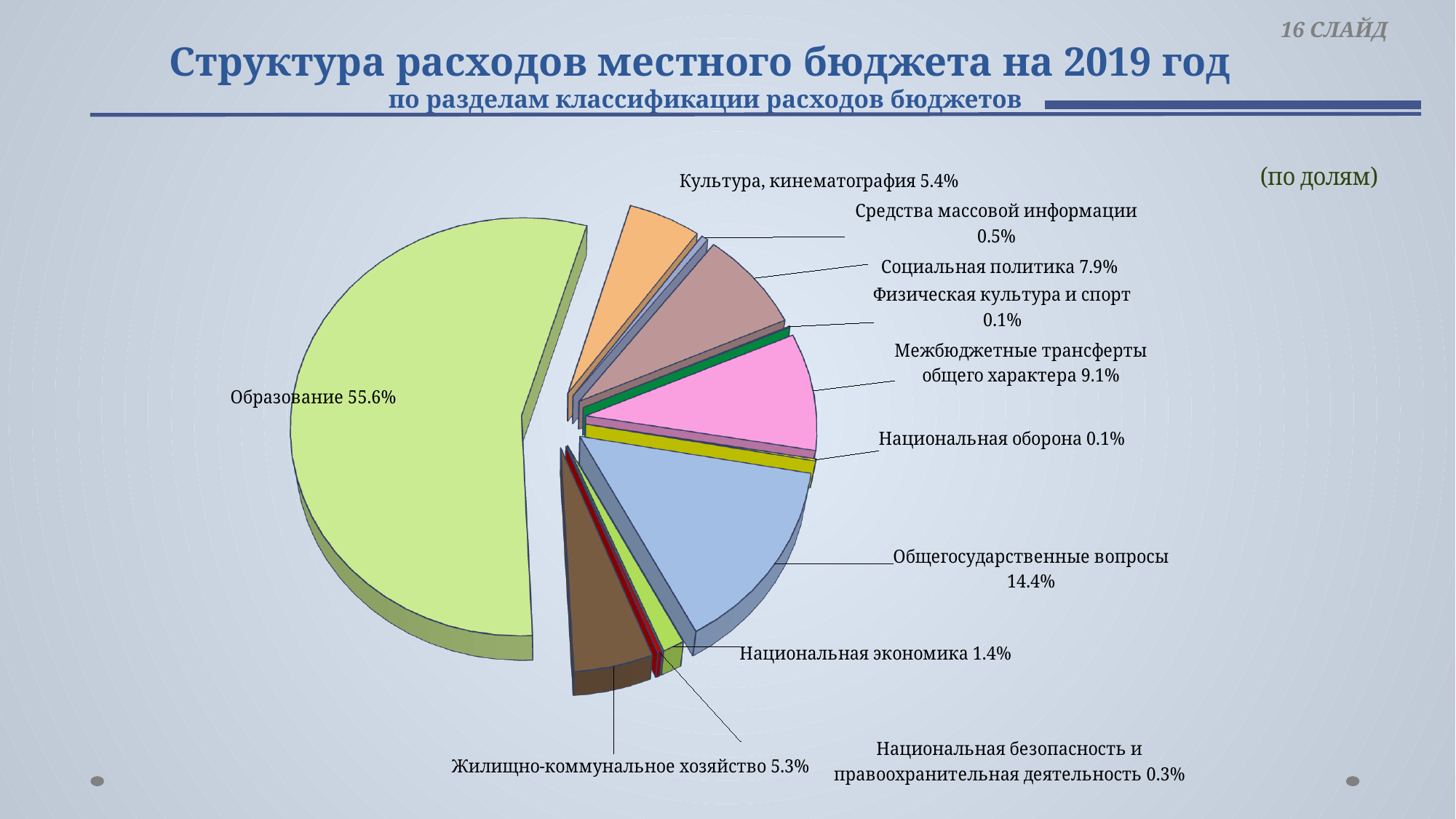
What is the value for Национальная безопасность и правоохранительная деятельность? 0.3% What share of the local budget expenditure goes to Образование? 55.6% What is the value for Жилищно-коммунальное хозяйство? 5.3% What is the value for Общегосударственные вопросы? 14.4% Which is larger, Культура, кинематография or Жилищно-коммунальное хозяйство? Культура, кинематография Which category has the largest share of the pie? Образование What is the value for Межбюджетные трансферты общего характера? 9.1% What is the value for Социальная политика? 7.9% What year does the chart title refer to? 2019 What type of chart is shown on the slide? pie chart What is the difference between Общегосударственные вопросы and Межбюджетные трансферты общего характера? 5.3% How many categories are shown in the pie chart? 11